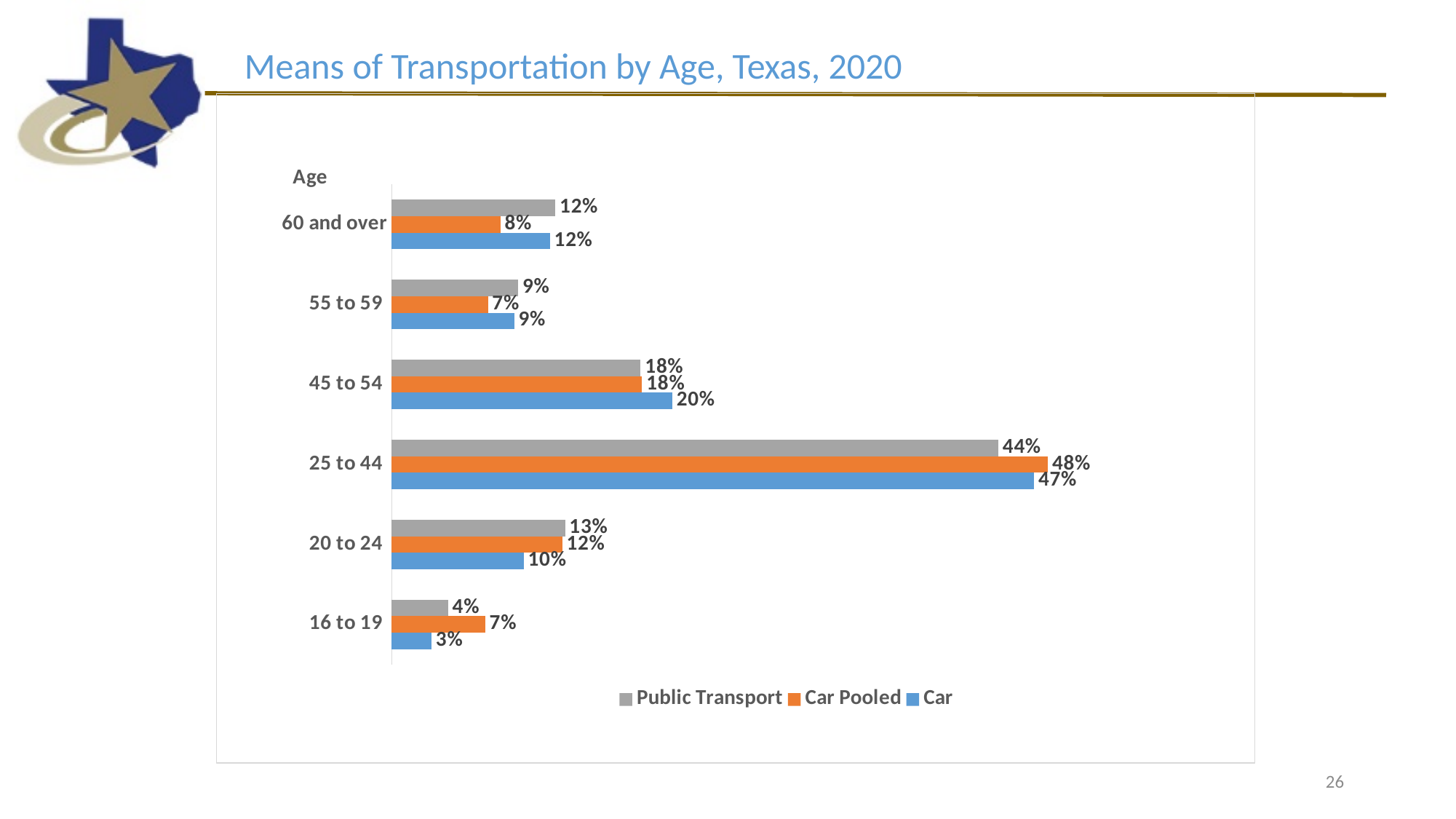
What is the Car Pooled value for the 16 to 19 age group? 7% Which is larger for the 20 to 24 age group, Public Transport or Car? Public Transport What is the difference between the Car Pooled and Public Transport values for the 25 to 44 age group? 4% Which age group has the lowest Car value? 16 to 19 What is the title of the chart? Means of Transportation by Age, Texas, 2020 Which age group has the highest Car Pooled value? 25 to 44 What is the Public Transport value for the 60 and over age group? 12% What is the Car value for the 25 to 44 age group? 47% What kind of chart is shown on the slide? Bar chart How many series does the legend list? 3 Which series is shown in orange? Car Pooled How many age groups are shown on the chart? 6